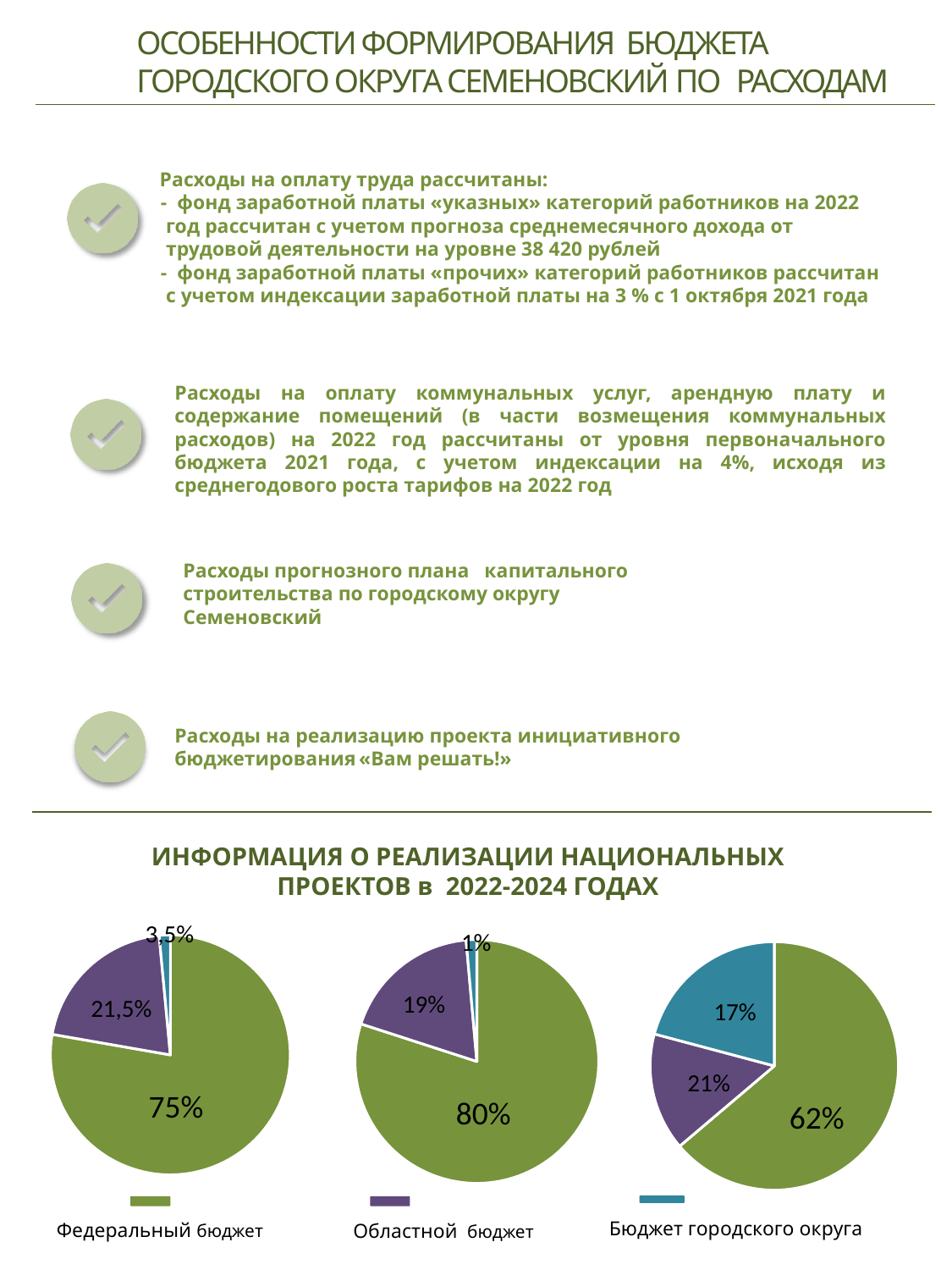
Which is larger: the Областной бюджет share in the left pie chart or in the middle pie chart? Left pie chart In the middle pie chart, what share does the Бюджет городского округа slice have? 1% In the left pie chart, what share does the Бюджет городского округа slice have? 3,5% In the middle pie chart, what share does the Федеральный бюджет slice have? 80% In the right pie chart, what is the difference between the Федеральный бюджет share and the Областной бюджет share? 41% How many series does the legend below the pie charts list? 3 In the left pie chart, what share does the Областной бюджет slice have? 21,5% What type of charts are shown at the bottom of the slide? Pie charts In the right pie chart, which budget source has the largest share? Федеральный бюджет In the left pie chart, what share does the Федеральный бюджет slice have? 75% In the middle pie chart, which budget source has the smallest share? Бюджет городского округа In the right pie chart, what share does the Бюджет городского округа slice have? 17%